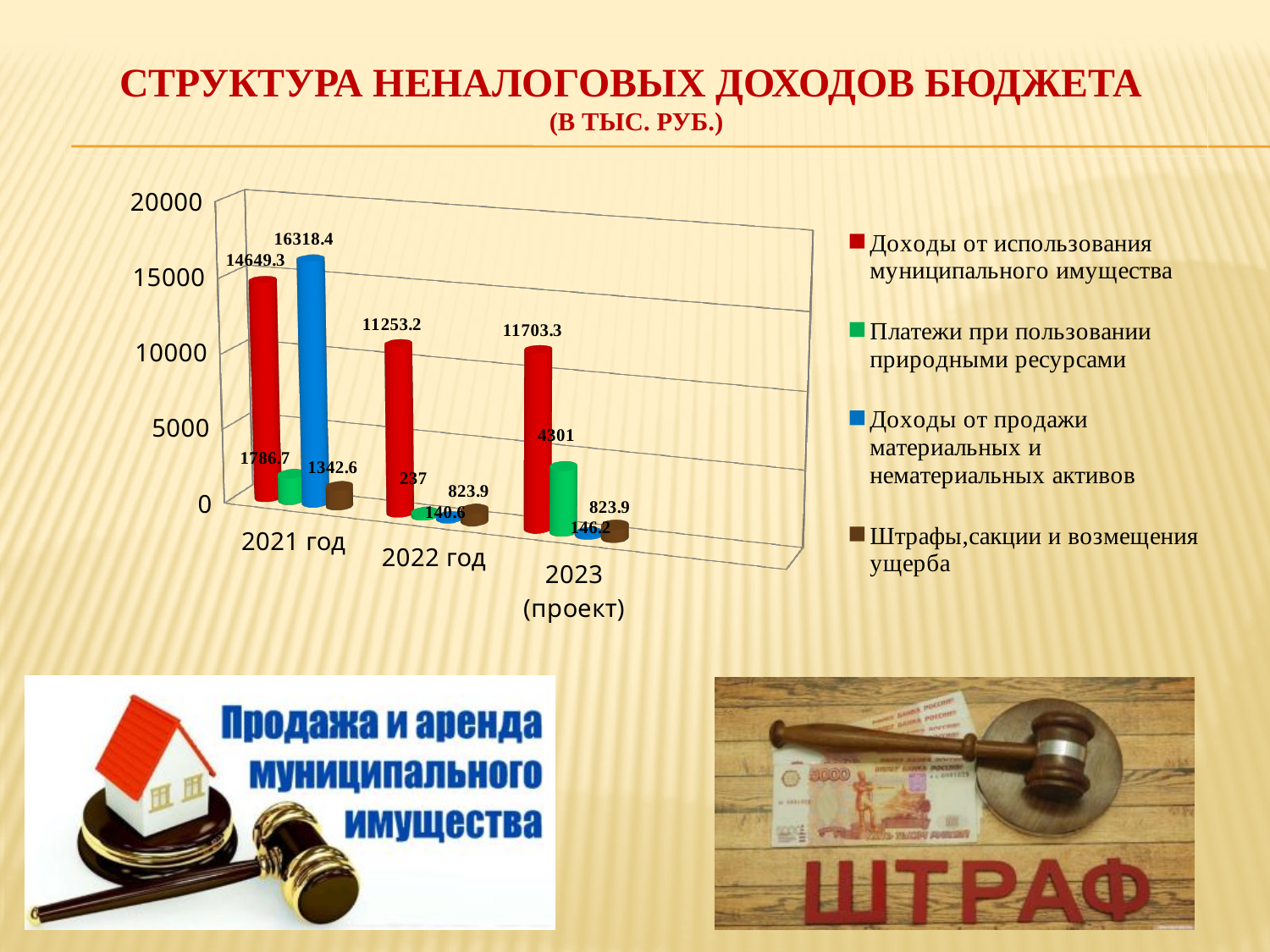
What is the value for Штрафы,сакции и возмещения ущерба in 2022 год? 823.9 What kind of chart is shown on the slide? bar chart What is the value for Доходы от использования муниципального имущества in 2021 год? 14649.3 How many year categories are shown on the x axis? 3 Which is larger in 2021 год: Доходы от использования муниципального имущества or Доходы от продажи материальных и нематериальных активов? Доходы от продажи материальных и нематериальных активов In which year is the value for Доходы от продажи материальных и нематериальных активов the highest? 2021 год What is the value for Платежи при пользовании природными ресурсами in 2023 (проект)? 4301 In which year is the value for Платежи при пользовании природными ресурсами the lowest? 2022 год What is the difference between the values for Доходы от использования муниципального имущества in 2023 (проект) and 2022 год? 450.1 How many series does the legend list? 4 What is the value for Доходы от продажи материальных и нематериальных активов in 2021 год? 16318.4 Is the value for Доходы от использования муниципального имущества in 2022 год greater or less than 10000? greater